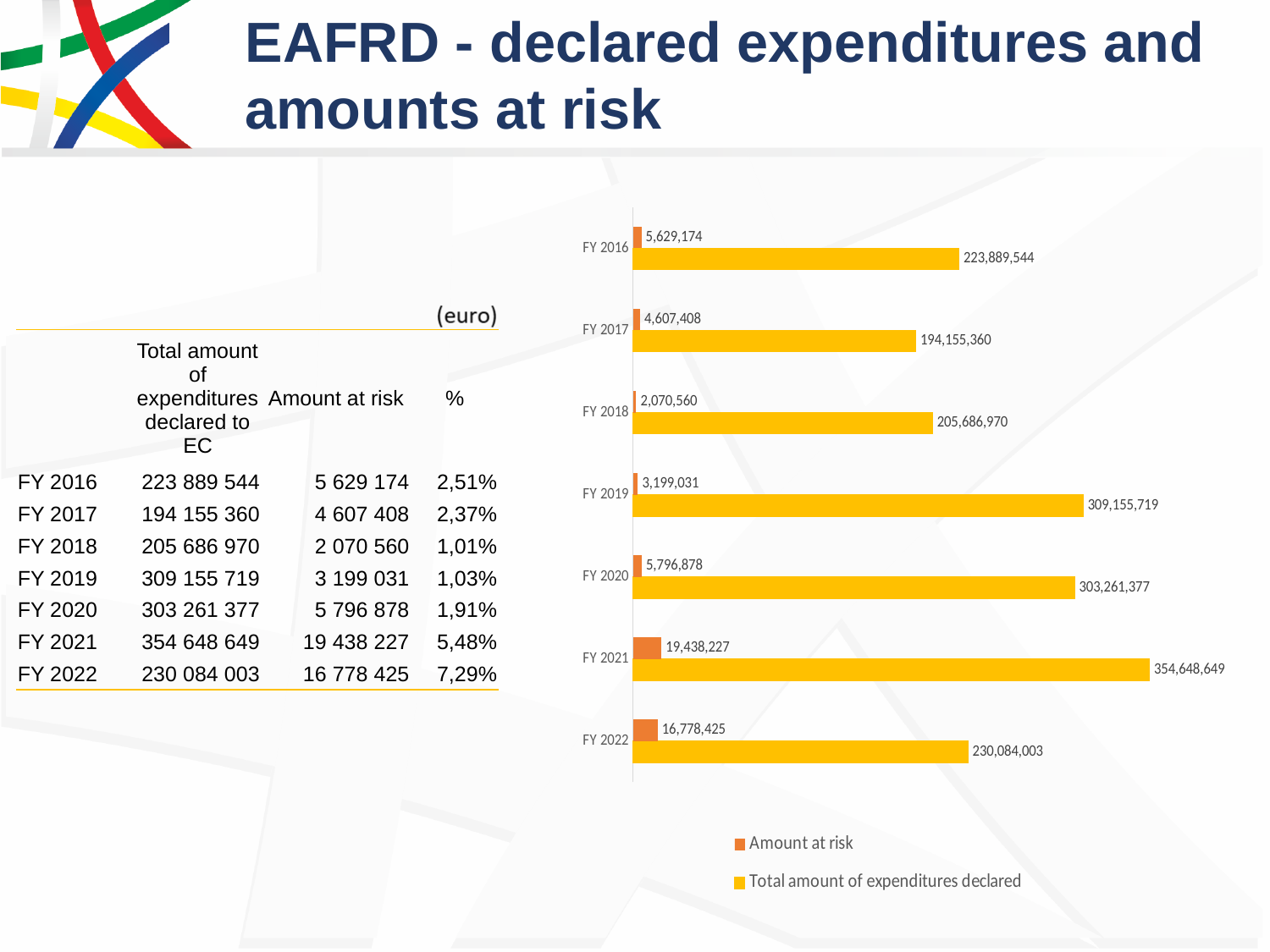
What is the total amount of expenditures declared for FY 2021 in the chart? 354,648,649 What is the amount at risk for FY 2018 in the chart? 2,070,560 Which is larger: the amount at risk for FY 2021 or for FY 2022? FY 2021 What is the difference between the total amount of expenditures declared in FY 2021 and FY 2022? 124,564,646 Which fiscal year has the lowest total amount of expenditures declared? FY 2017 Which fiscal year has the highest total amount of expenditures declared? FY 2021 How many series does the chart legend list? 2 Which fiscal year has the lowest amount at risk? FY 2018 What is the amount at risk for FY 2022 in the chart? 16,778,425 What is the total amount of expenditures declared for FY 2017 in the chart? 194,155,360 How many fiscal years are shown in the chart? 7 What type of chart is shown on the slide? Bar chart